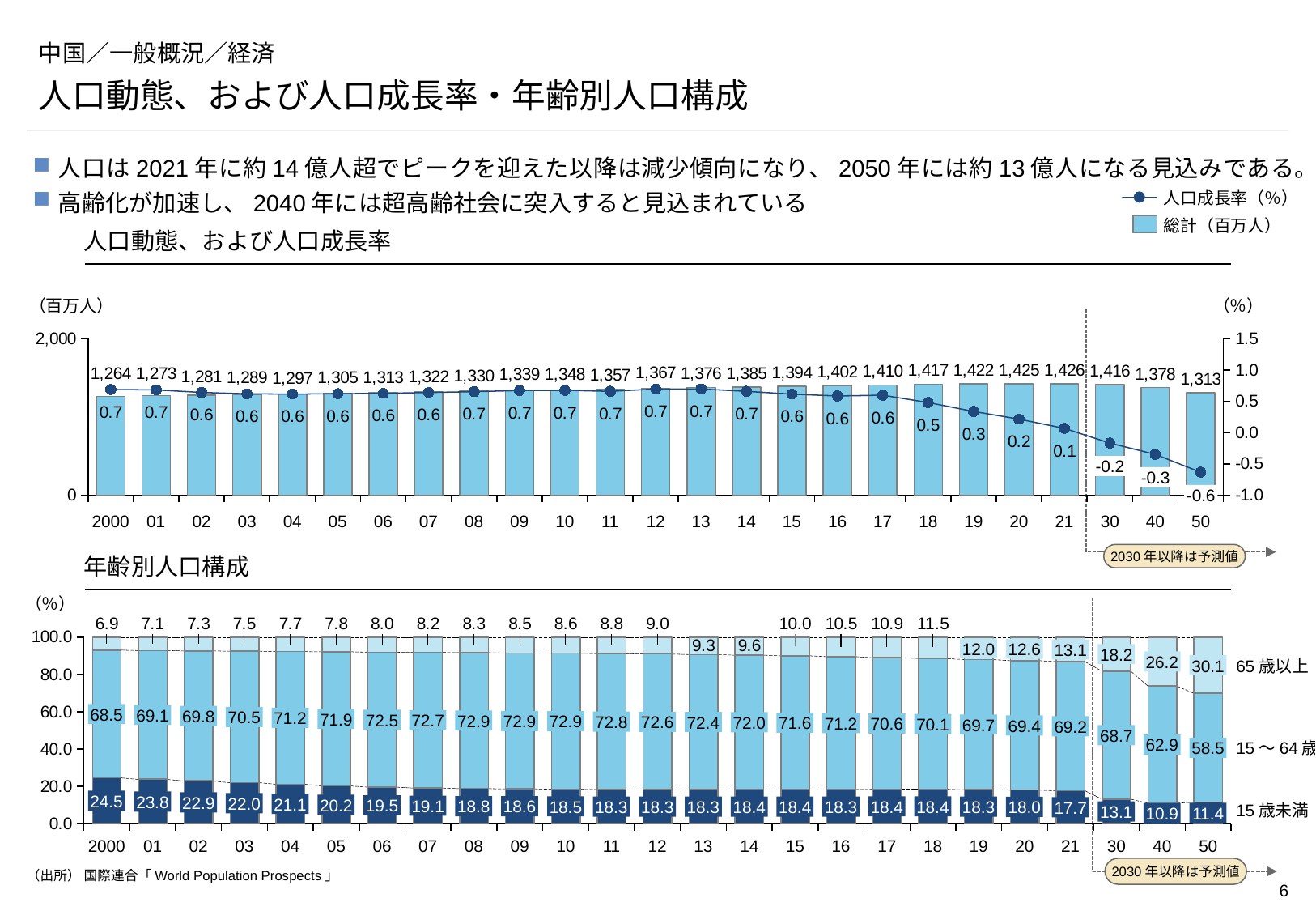
What kind of chart is the bottom chart (年齢別人口構成)? stacked bar chart In the top chart (人口動態、および人口成長率), what is the population growth rate (%) shown for 2018? 0.5 In the top chart (人口動態、および人口成長率), which year has the highest total population? 2021 (1,426) In the bottom chart (年齢別人口構成), what percentage is shown for 15歳未満 in 2000? 24.5 In the bottom chart (年齢別人口構成), what percentage is shown for 65歳以上 in 2050? 30.1 In the top chart (人口動態、および人口成長率), what is the difference between the total population in 2021 and in 2000? 162 In the top chart (人口動態、および人口成長率), what is the total population (百万人) shown for 2000? 1,264 In the bottom chart (年齢別人口構成), does the share of 15歳未満 rise or fall from 2000 to 2050? fall In the top chart (人口動態、および人口成長率), what is the population growth rate (%) shown for 2050? -0.6 In the top chart (人口動態、および人口成長率), which is larger: the total population in 2030 or in 2050? 2030 (1,416) In the bottom chart (年齢別人口構成), how many years (categories) are shown on the x axis? 25 In the top chart (人口動態、および人口成長率), how many series does the legend list? 2